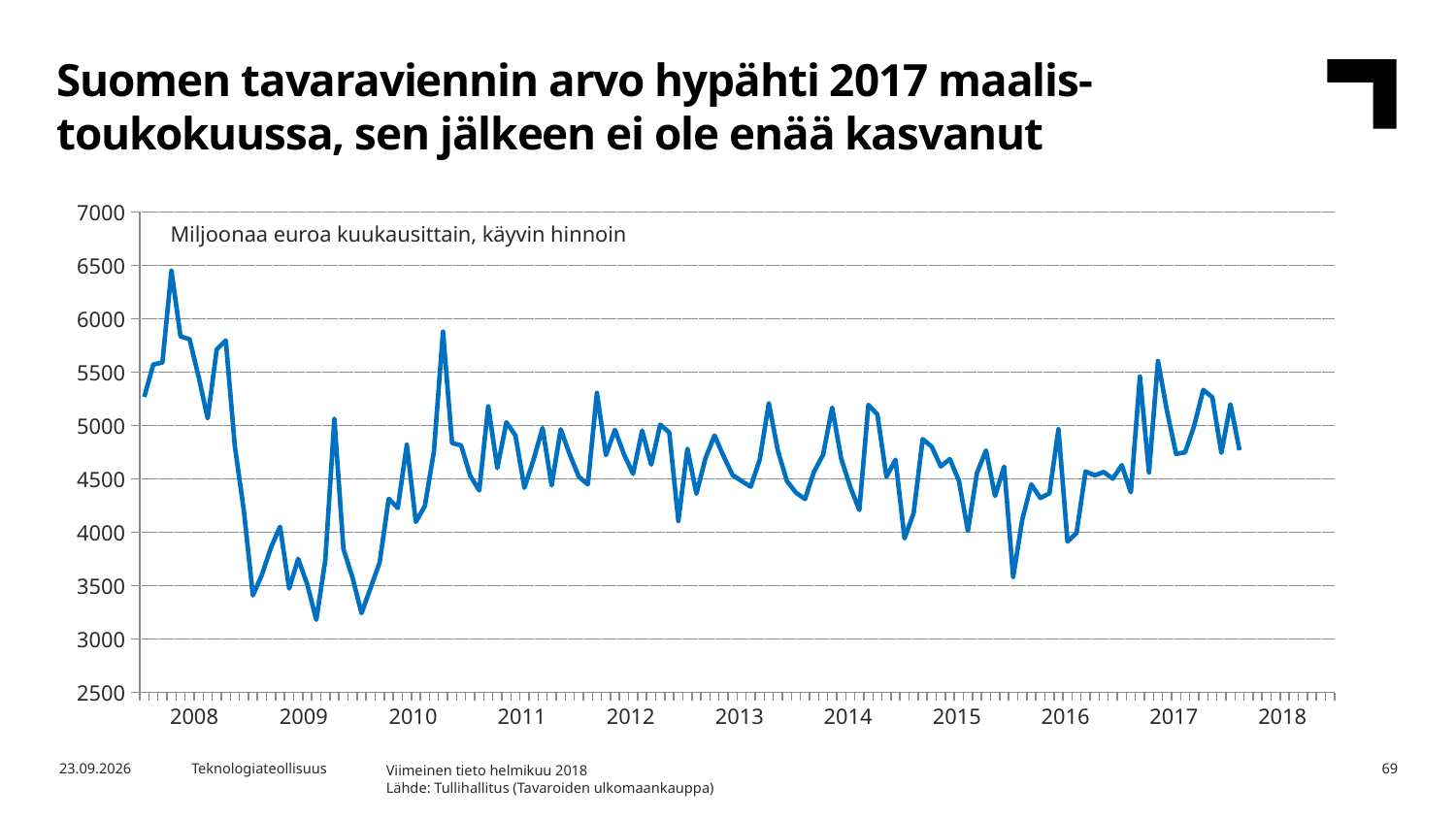
Does the line rise or fall from the start of 2008 to the start of 2009? fall Is the lowest value of the line in 2009 greater or less than 3500? less What is the lowest value shown on the vertical axis? 2500 In which year does the line reach its lowest point? 2009 What kind of chart is shown on the slide? line chart Is the highest value of the line in 2008 greater or less than 6000? greater What is the subtitle printed inside the chart area describing the unit of the values? Miljoonaa euroa kuukausittain, käyvin hinnoin Is the last plotted value in 2018 greater or less than 5000? less In which year does the line reach its highest point? 2008 How many year labels are shown on the horizontal axis? 11